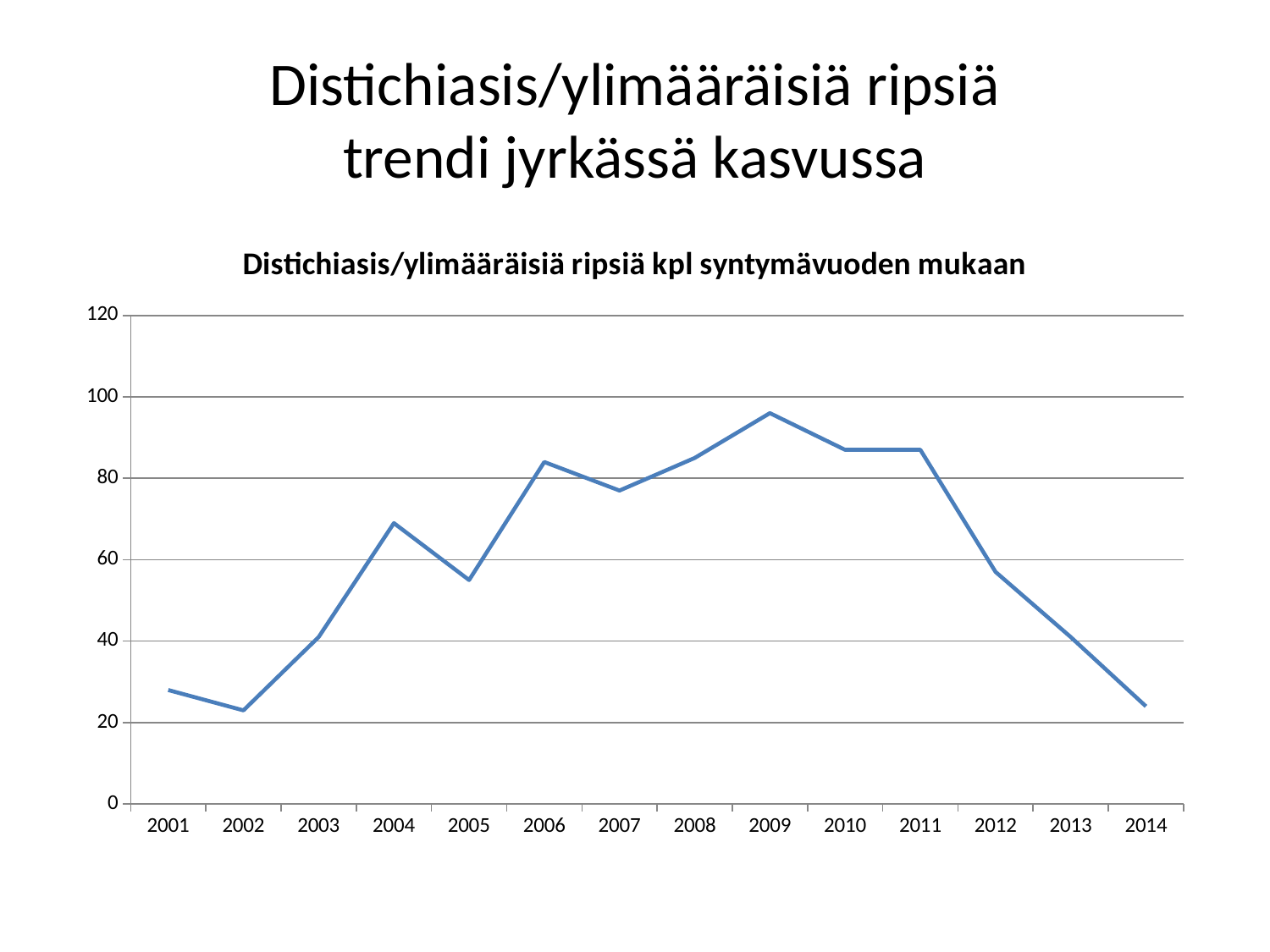
Is the value for 2004 greater or less than 60? greater Which year has the highest value on the chart? 2009 Is the value for 2012 greater or less than 80? less What kind of chart is shown on the slide? line chart Do the values rise or fall from 2011 to 2014? fall How many years are plotted along the x axis? 14 Is the value for 2002 greater or less than 40? less Which year has the larger value, 2004 or 2005? 2004 Which year has the larger value, 2009 or 2012? 2009 What is the title of the chart? Distichiasis/ylimääräisiä ripsiä kpl syntymävuoden mukaan